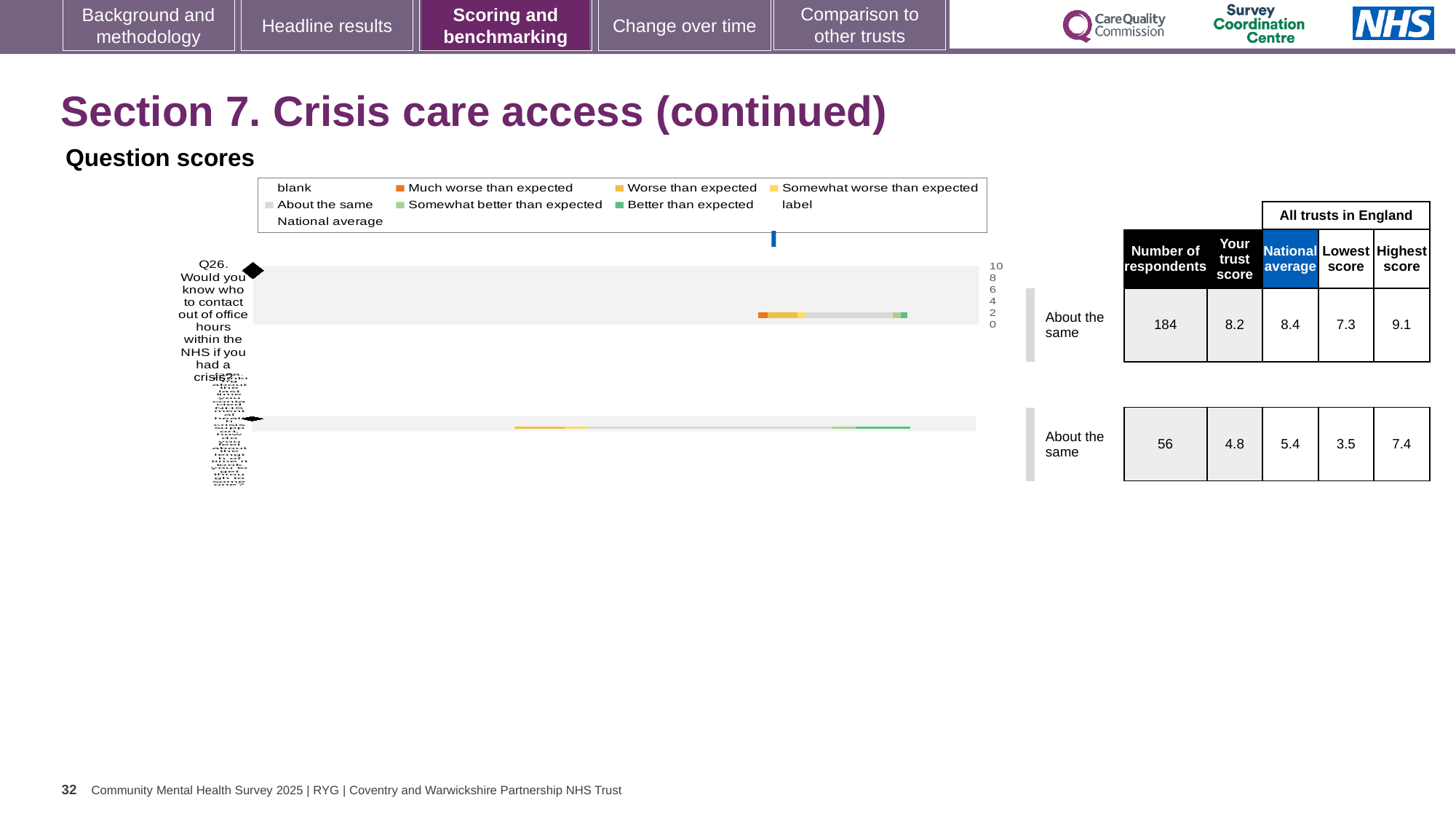
What is the highest score among all trusts in England for Q26? 9.1 What kind of chart is used to show the question scores on this slide? bar chart What is the difference between the national average (5.4) and the trust score (4.8) for the second question bar? 0.6 How many respondents answered Q26? 184 What is the trust score for the second question bar in the chart? 4.8 How many question bars are plotted in the question scores chart? 2 For Q26, which is larger: the trust score or the national average? national average What is the difference between the highest score (9.1) and the lowest score (7.3) for Q26? 1.8 What benchmark category is shown for Q26 next to the chart? About the same What is the national average score for Q26? 8.4 What is the trust score for Q26 (Would you know who to contact out of office hours within the NHS if you had a crisis?)? 8.2 In the question scores chart legend, which entry is shown in orange? Much worse than expected